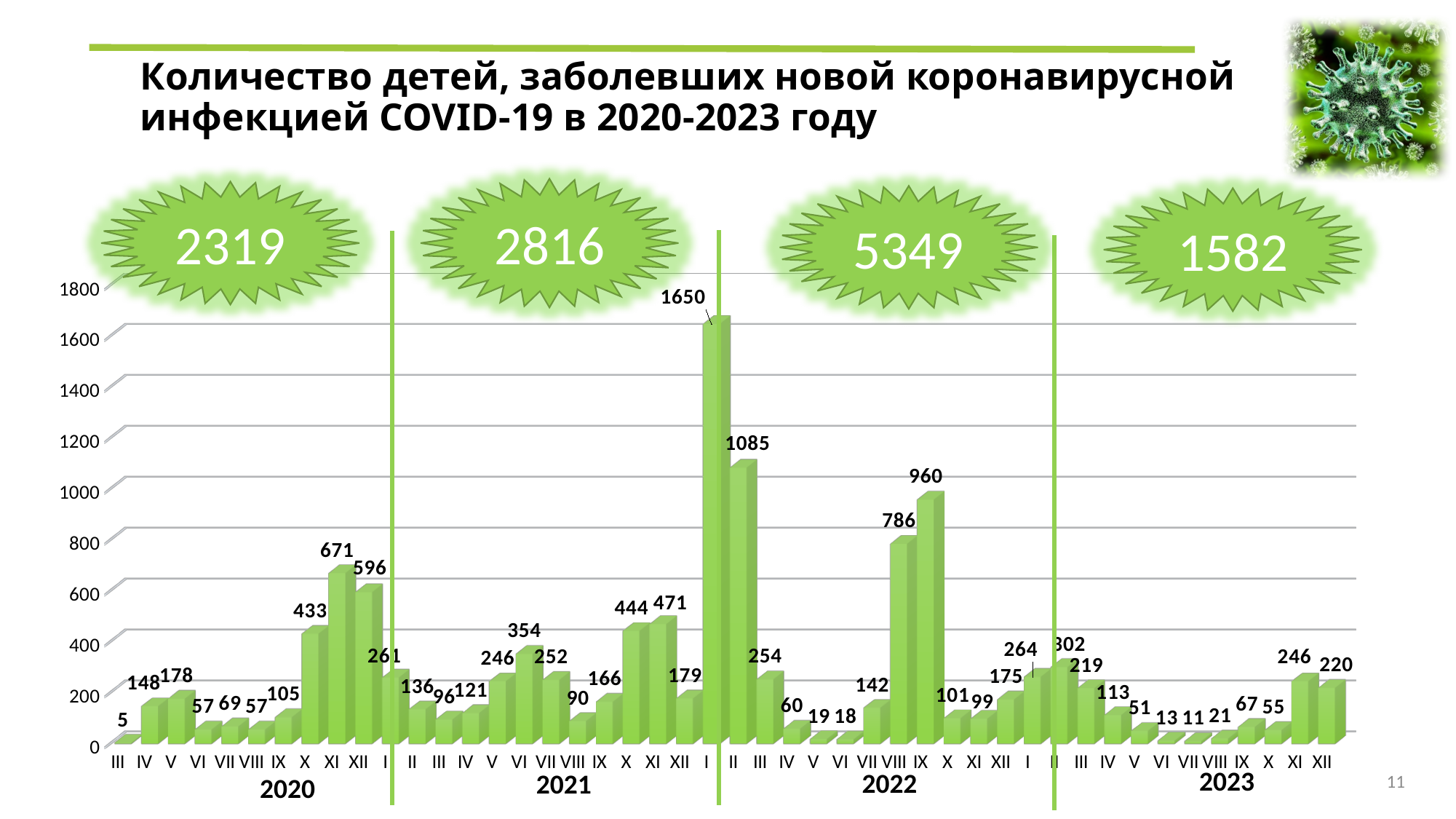
Is the value for August 2022 (VIII, 2022) greater or less than 600? greater How many monthly bars are plotted on the chart? 46 What kind of chart is shown on the slide? bar chart Which month has the lowest value on the chart? March 2020 (III, 2020) What is the value for September 2022 (IX, 2022)? 960 What yearly total is shown in the starburst above the 2022 section of the chart? 5349 Do the values rise or fall from September 2020 (IX) to November 2020 (XI)? rise What is the value for November 2020 (XI, 2020)? 671 What is the value for January 2022 (I, 2022)? 1650 Which month has the highest value on the chart? January 2022 (I, 2022) What is the difference between the values for January 2022 (1650) and February 2022 (1085)? 565 Which is larger: the value for June 2021 (VI, 2021) or the value for July 2021 (VII, 2021)? June 2021 (VI, 2021)